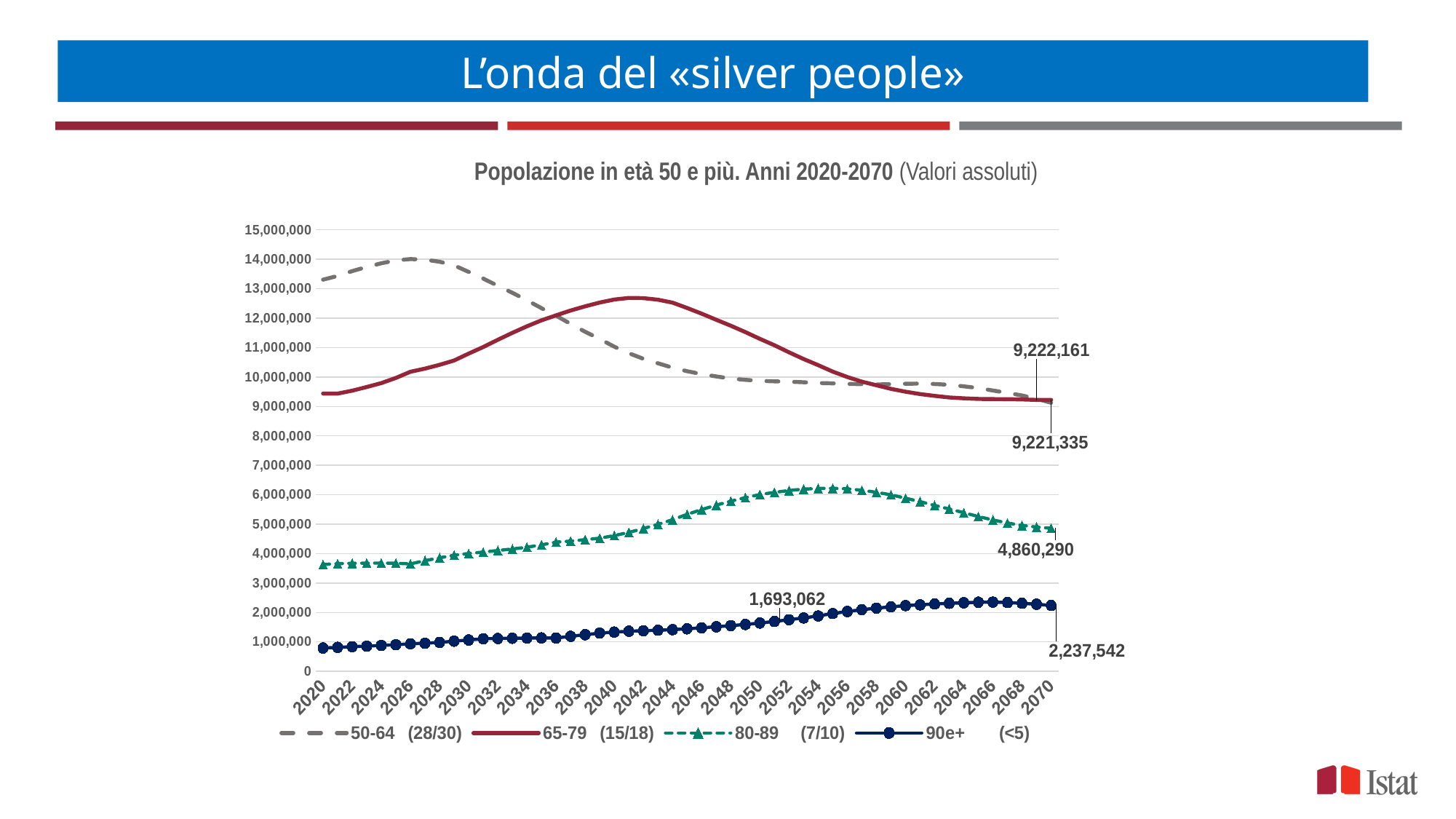
What is the value for the 90e+ series in 2070? 2,237,542 What is the value labelled on the 90e+ series in 2052? 1,693,062 Which series has the highest value in 2020? 50-64 How many series does the legend list? 4 Is the value for the 65-79 series in 2020 greater or less than 10,000,000? less What kind of chart is shown on the slide? line chart By how much does the 90e+ series grow between 2052 and 2070? 544,480 What is the title of the chart? Popolazione in età 50 e più. Anni 2020-2070 (Valori assoluti) What is the value for the 80-89 series in 2070? 4,860,290 Does the 90e+ series rise or fall between 2020 and 2060? rise Is the value for the 50-64 series in 2026 greater or less than 13,000,000? greater In 2040, which series is larger: 65-79 or 50-64? 65-79